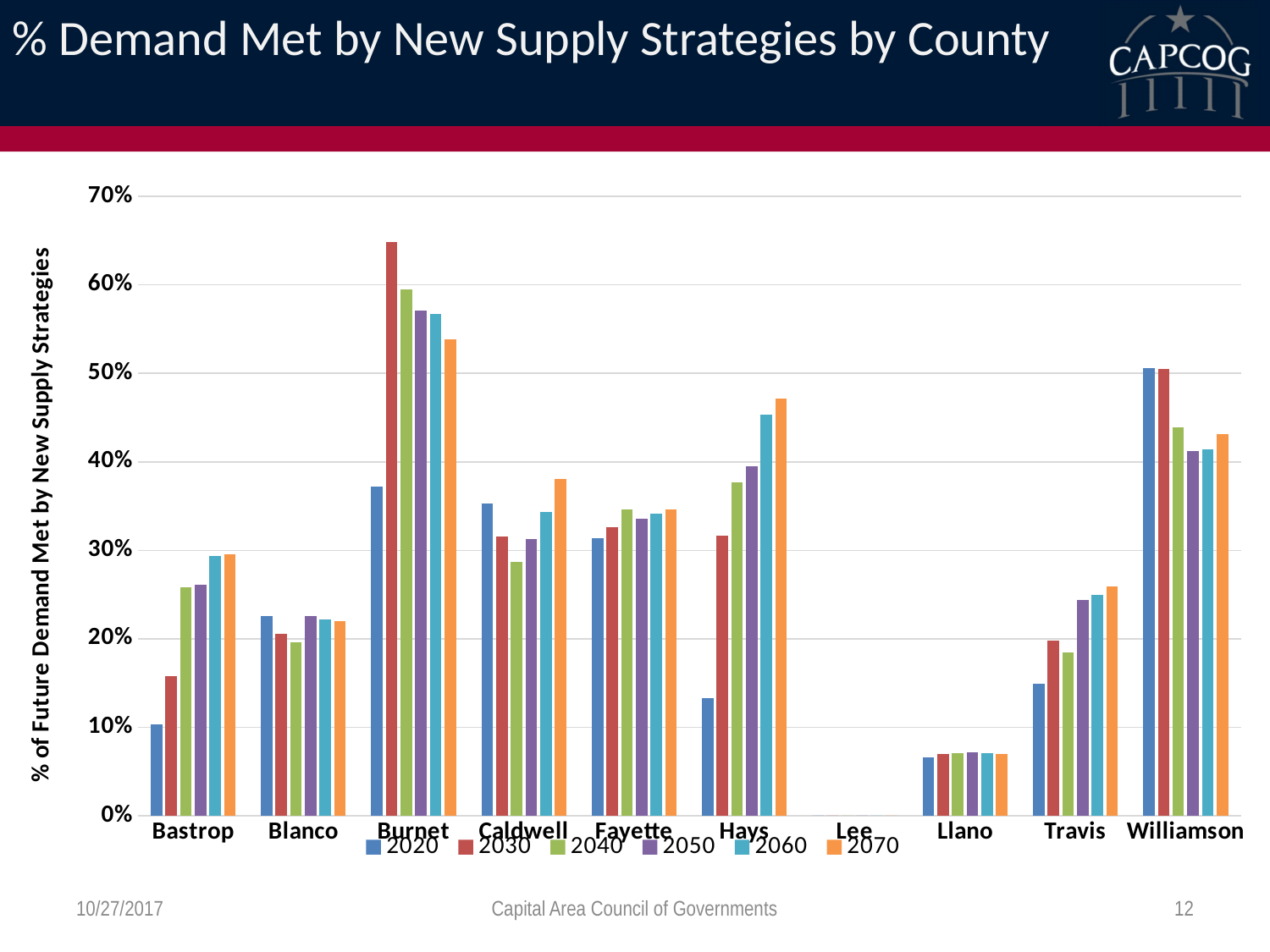
Is the 2020 value for Bastrop greater or less than 20%? less Do the values for Bastrop rise or fall from 2020 to 2070? rise How many series does the legend list? 6 Which is larger, the 2070 value for Hays or the 2070 value for Williamson? Hays What kind of chart is shown on the slide? bar chart Do the values for Burnet rise or fall from 2030 to 2070? fall Is the 2070 value for Travis greater or less than 30%? less Is the 2030 value for Burnet greater or less than 60%? greater Which county has the highest value for 2030? Burnet How many counties are shown on the x axis? 10 What is the title of the y axis? % of Future Demand Met by New Supply Strategies